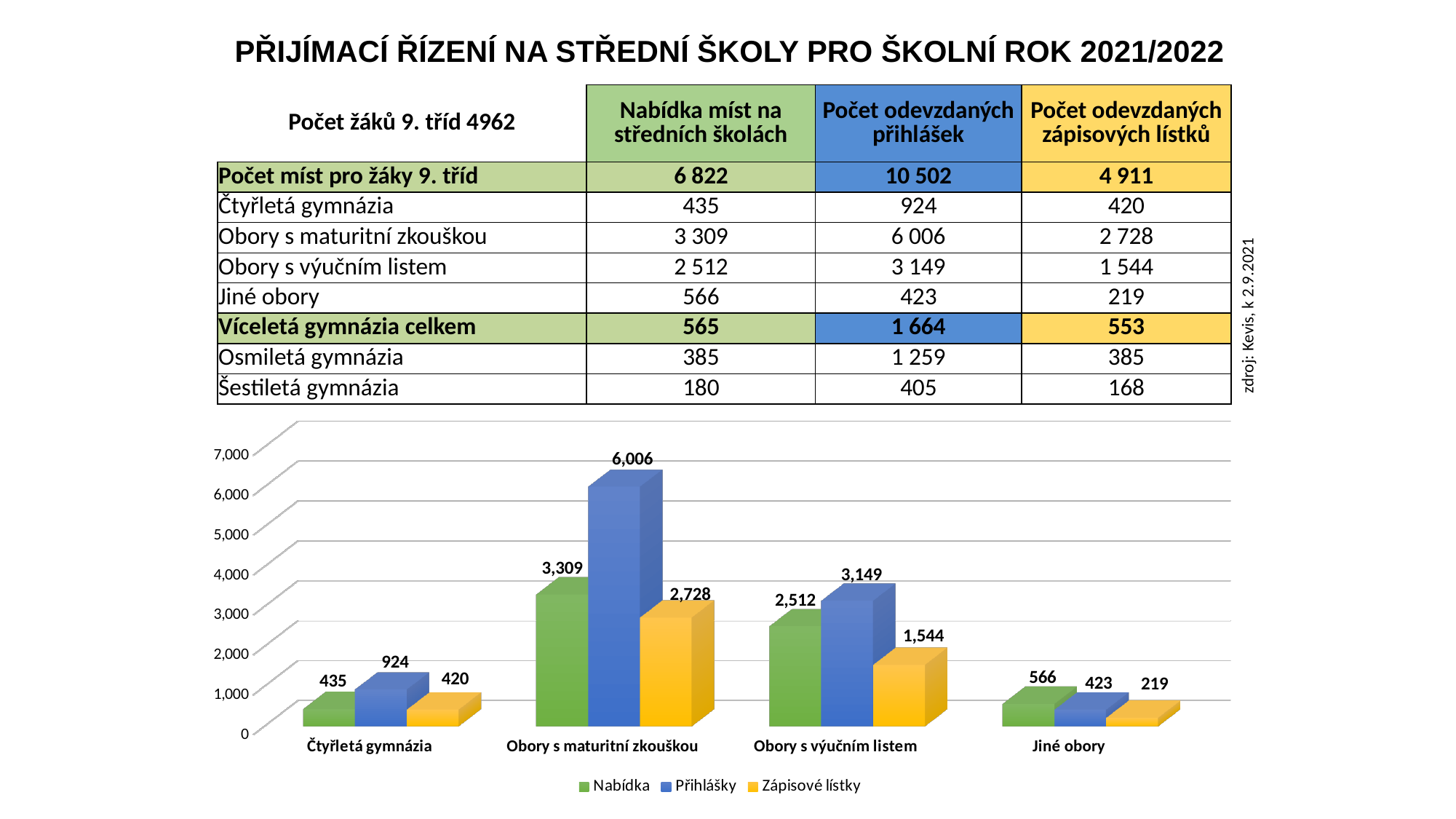
Is the Přihlášky value for Obory s výučním listem greater or less than 3,000? greater Which category has the lowest Zápisové lístky value in the chart? Jiné obory What is the value of Nabídka for Obory s výučním listem in the chart? 2,512 Which category has the highest Přihlášky value in the chart? Obory s maturitní zkouškou What is the value of Zápisové lístky for Čtyřletá gymnázia in the chart? 420 For Jiné obory, which is larger in the chart: Nabídka or Přihlášky? Nabídka What is the difference between Přihlášky and Nabídka for Obory s maturitní zkouškou in the chart? 2,697 Which colour represents the Zápisové lístky series in the chart? Yellow How many series does the chart legend list? 3 What is the value of Přihlášky for Obory s maturitní zkouškou in the chart? 6,006 What kind of chart is shown on the slide? Bar chart How many categories are shown on the x axis of the chart? 4